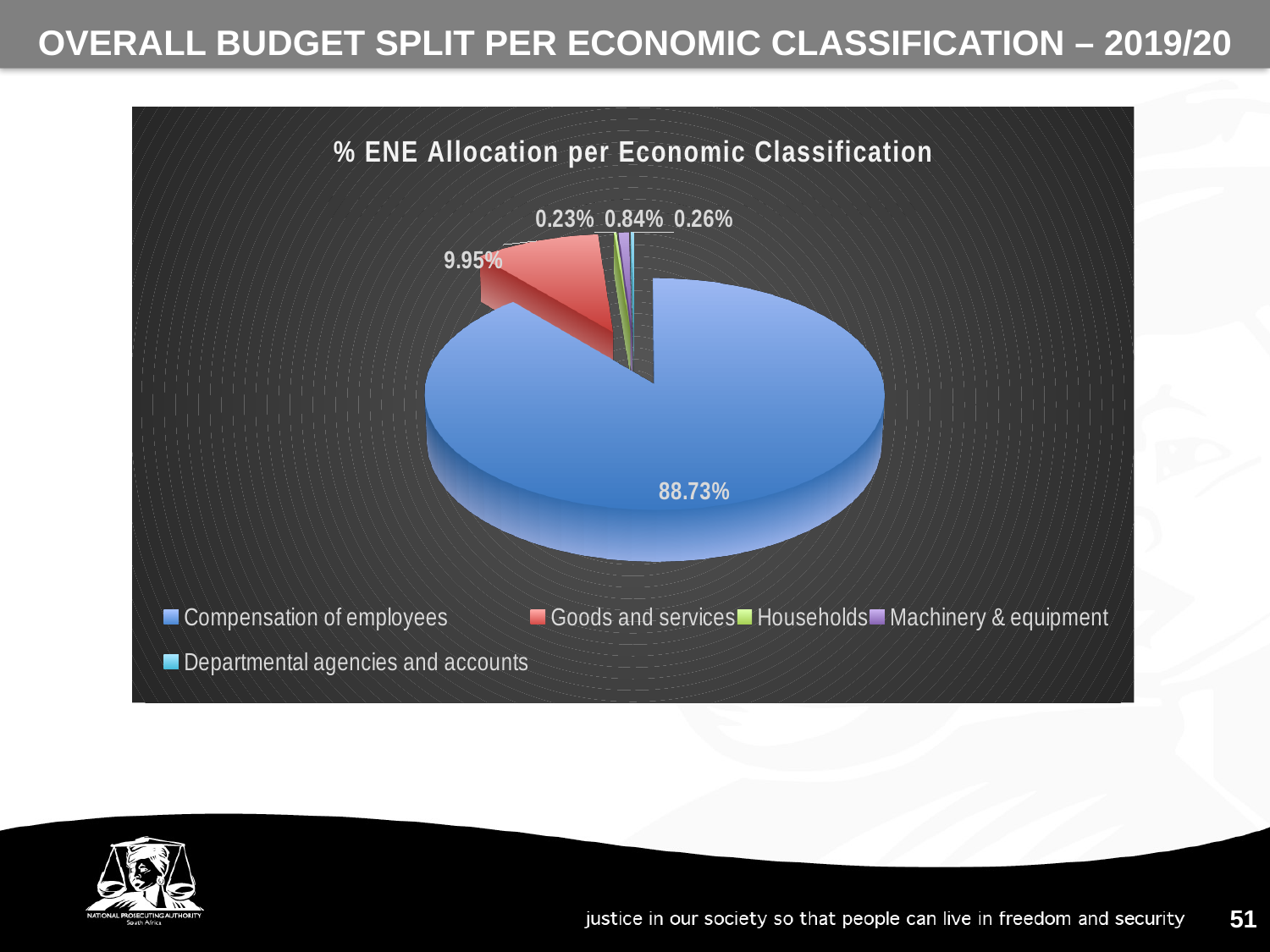
What is the difference in percentage points between Compensation of employees and Goods and services? 78.78 What share of the pie does Compensation of employees take? 88.73% What type of chart is shown on the slide? Pie chart How many categories does the legend list? 5 What percentage is shown for Machinery & equipment? 0.84% Is the share for Compensation of employees greater or less than 80%? greater What percentage is shown for Goods and services? 9.95% Which is larger, the share for Goods and services or the share for Machinery & equipment? Goods and services Which economic classification has the largest share of the ENE allocation? Compensation of employees What is the title of the chart? % ENE Allocation per Economic Classification Which category has the second-largest slice of the pie? Goods and services What is the combined share of Compensation of employees and Goods and services? 98.68%